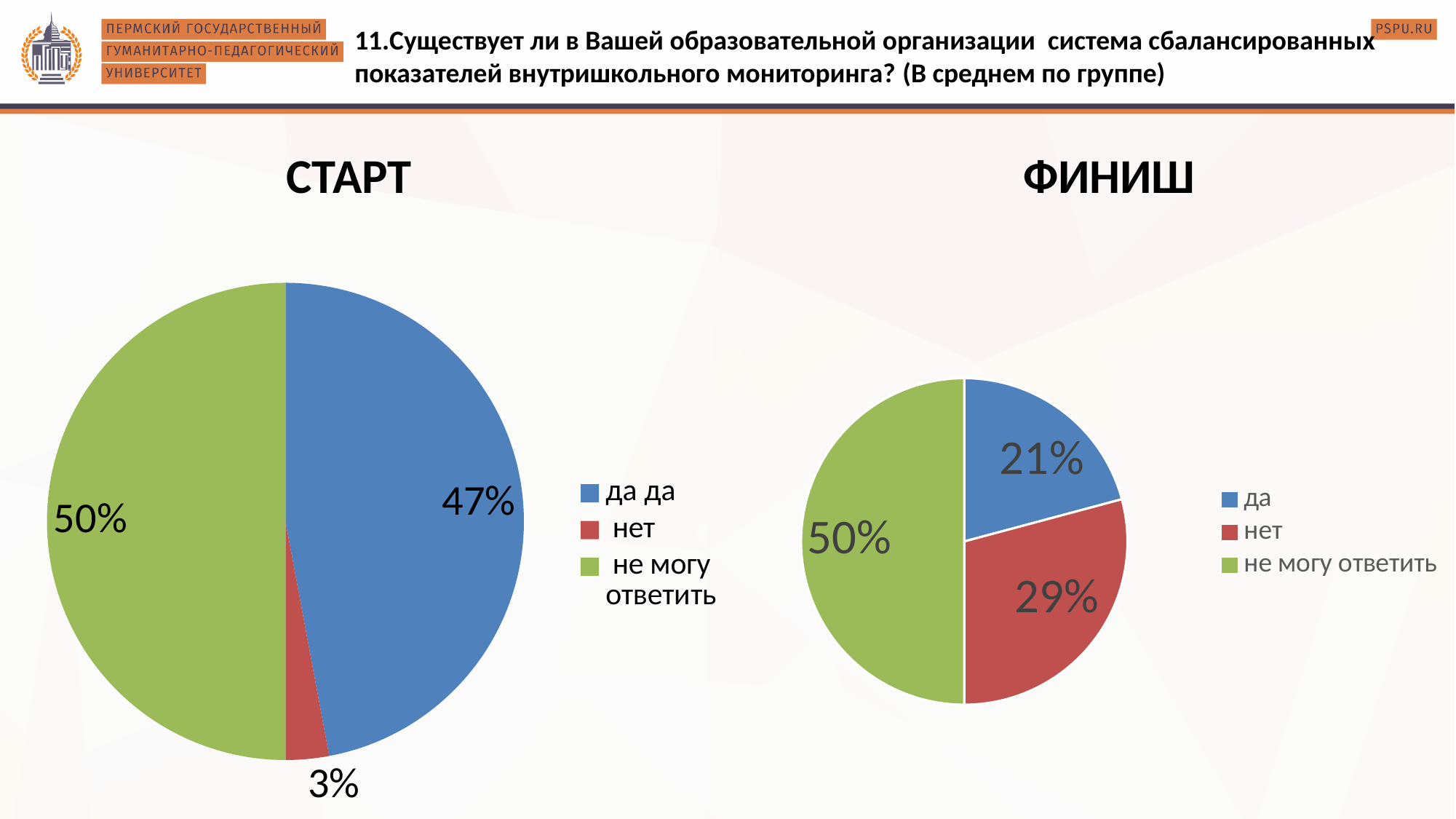
What is the difference between the нет share in the ФИНИШ chart and the нет share in the СТАРТ chart? 26% In the ФИНИШ pie chart, what share is shown for да? 21% In the СТАРТ pie chart, which category has the smallest slice? нет In the СТАРТ chart legend, what colour represents не могу ответить? Green In the ФИНИШ pie chart, what share is shown for нет? 29% In the ФИНИШ pie chart, which is larger: the share for да or the share for нет? нет In the СТАРТ pie chart, what share is shown for нет? 3% In the СТАРТ pie chart, what share is labelled for the blue slice (да да)? 47% How many slices does the ФИНИШ pie chart have? 3 What type of chart is used for СТАРТ? Pie chart In the ФИНИШ pie chart, which category has the largest slice? не могу ответить In the СТАРТ pie chart, what share is shown for не могу ответить? 50%